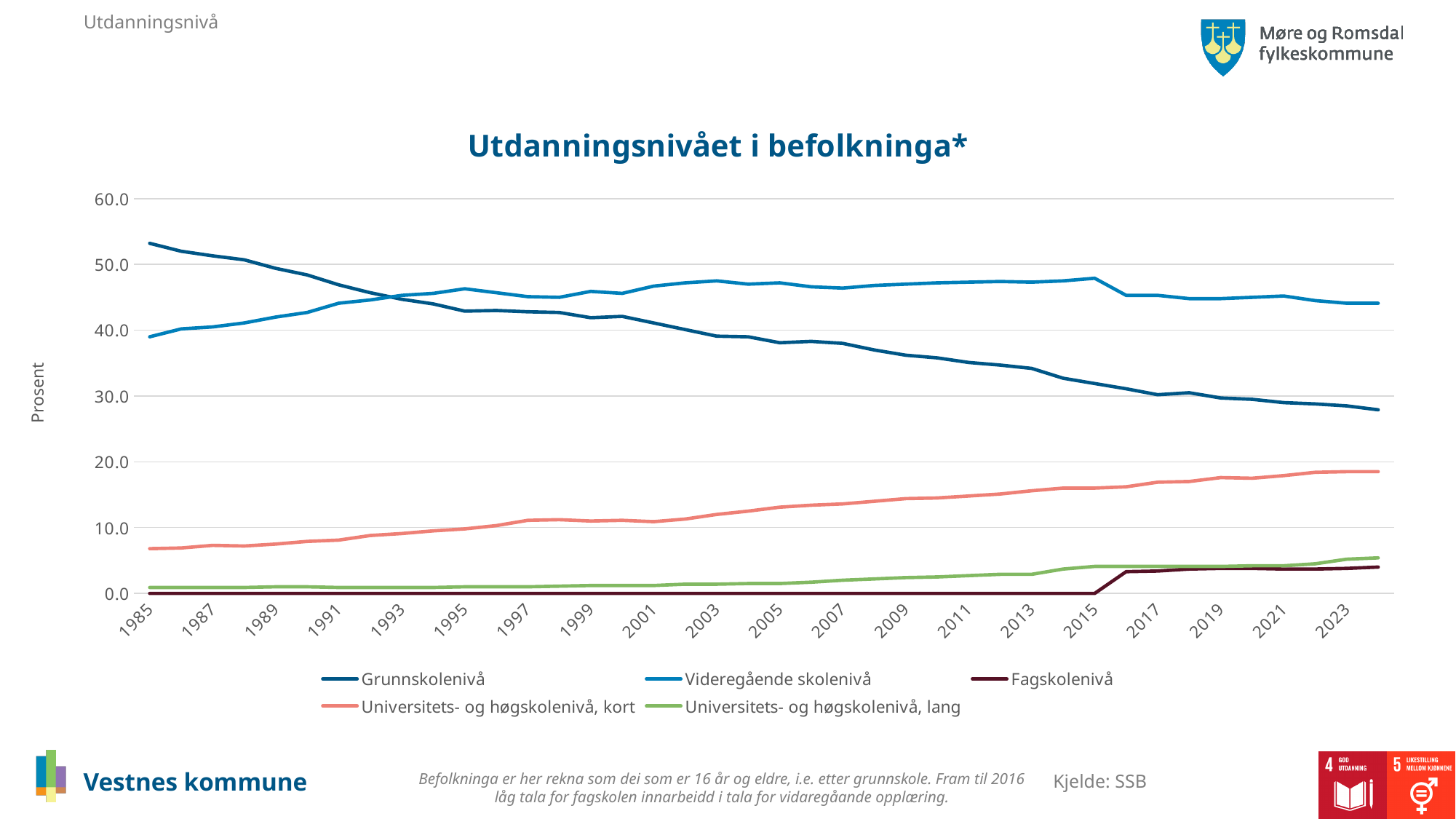
Is the value for Grunnskolenivå in 2023 greater or less than 30.0? less What kind of chart is shown on the slide? line chart Is the value for Grunnskolenivå in 1985 greater or less than 50.0? greater Which series has the highest value in 2023? Videregående skolenivå Is the value for Universitets- og høgskolenivå, kort in 2023 greater or less than 20.0? less Does the Universitets- og høgskolenivå, kort line rise or fall from 1985 to 2023? rise In 1985, which is larger: Grunnskolenivå or Videregående skolenivå? Grunnskolenivå What is the label on the vertical axis of the chart? Prosent How many series does the legend list? 5 What is the title of the chart? Utdanningsnivået i befolkninga* Does the Grunnskolenivå line rise or fall from 1985 to 2023? fall